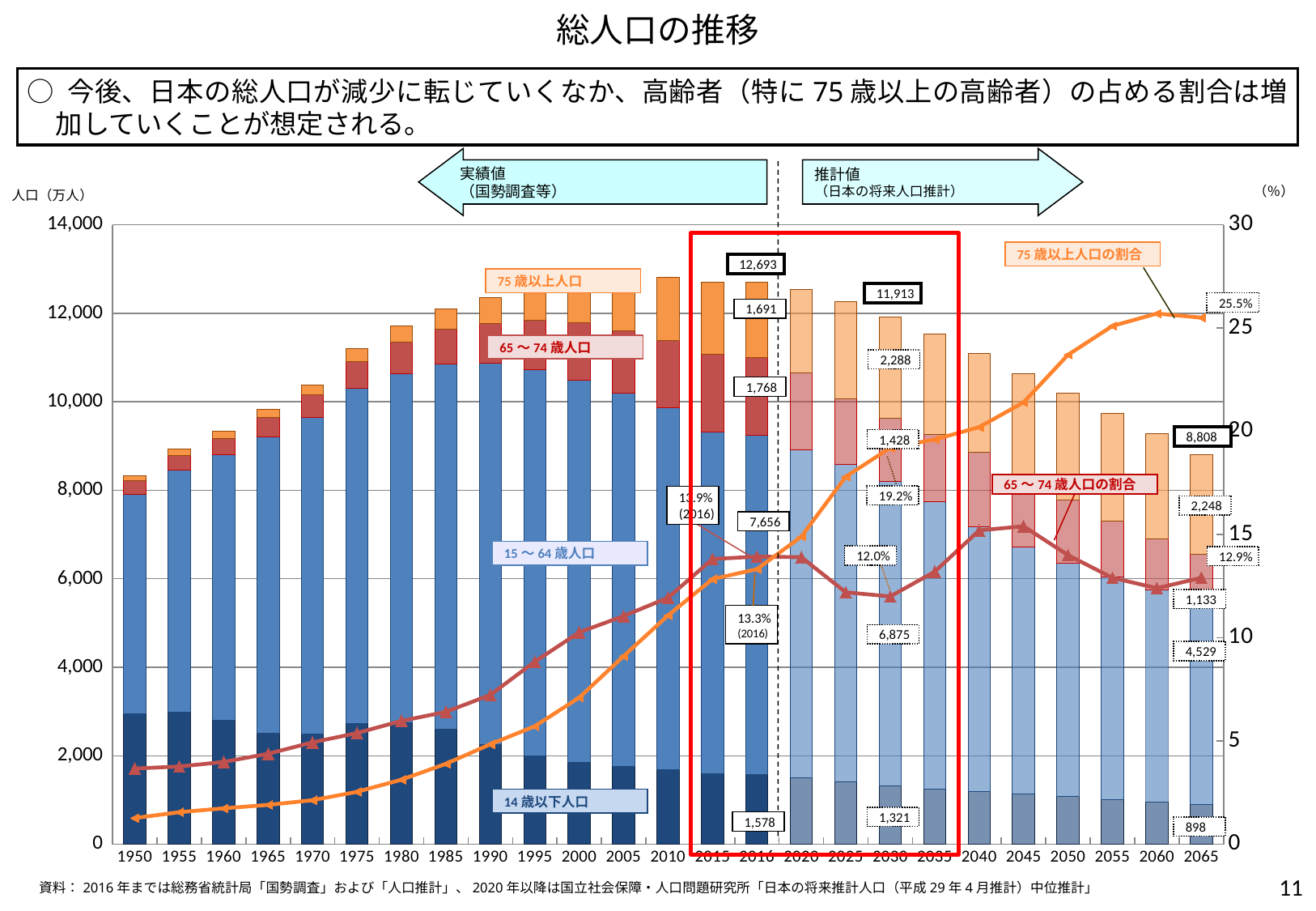
What is the 14歳以下人口 value shown for 2065? 898 What is the 65～74歳人口の割合 shown for 2030? 12.0% What is the 15～64歳人口 value shown for 2016? 7,656 What is the 75歳以上人口の割合 shown for 2065? 25.5% Is the total population bar for 2050 greater or less than 10,000? greater Which is larger in 2030, the 75歳以上人口 or the 65～74歳人口? 75歳以上人口 What is the 75歳以上人口 value shown for 2030? 2,288 Does the 75歳以上人口の割合 line generally rise or fall from 1950 to 2060? rise What is the total population shown for 2065? 8,808 What is the title of the chart? 総人口の推移 By how much does the total population shown for 2016 exceed that shown for 2065? 3,885 What is the total population shown for 2016? 12,693